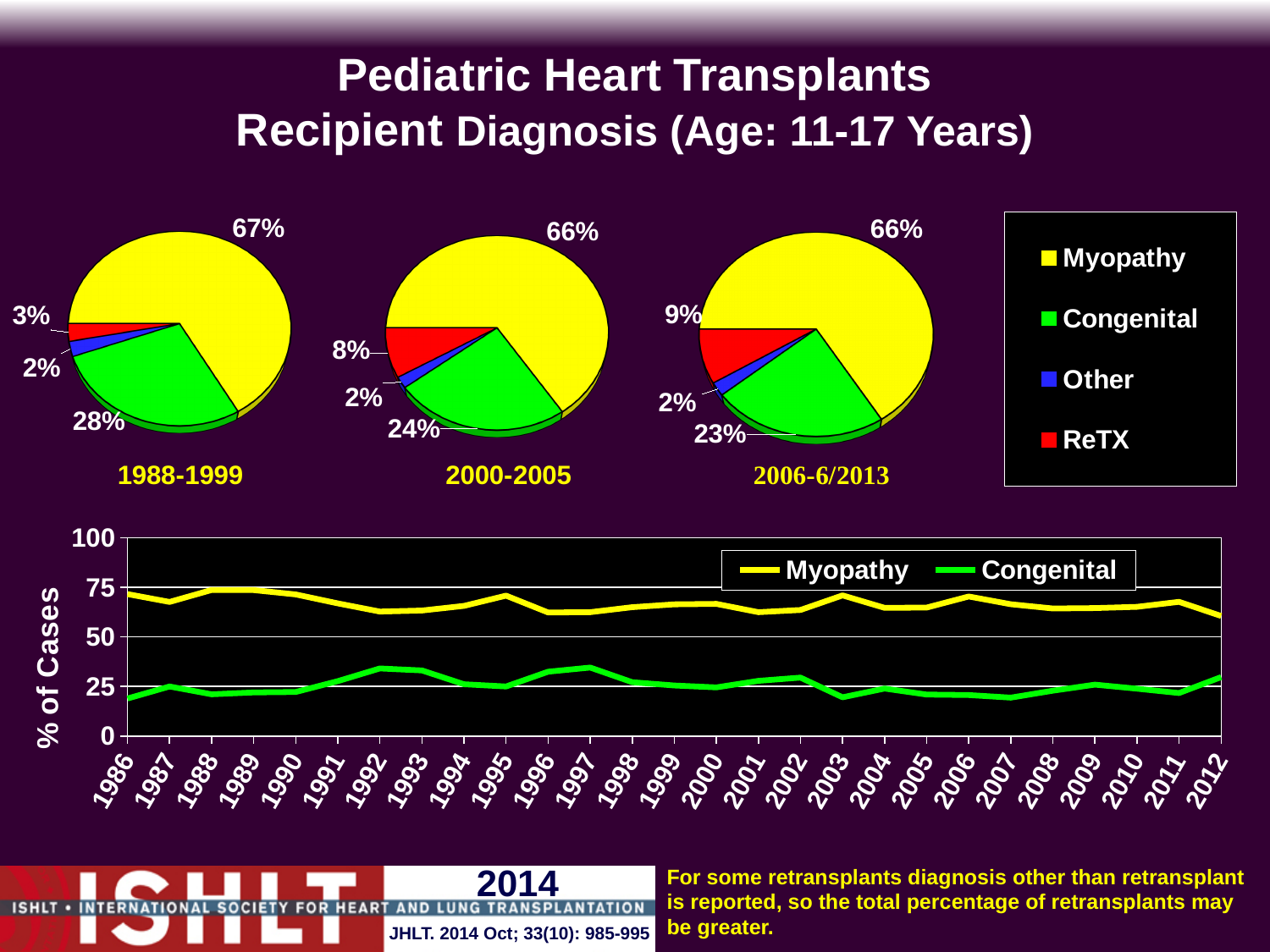
In the 2006-6/2013 pie chart, which diagnosis has the largest share? Myopathy How many pie charts are shown on the slide? 3 In the 1988-1999 pie chart, what percentage of cases is Myopathy? 67% In the 2000-2005 pie chart, which diagnosis has the smallest share? Other How many series does the legend of the line chart at the bottom list? 2 In the 2006-6/2013 pie chart, what percentage of cases is Congenital? 23% In the 2000-2005 pie chart, what percentage of cases is ReTX? 8% What kind of chart is the chart at the bottom of the slide? Line chart Is the ReTX share larger in the 1988-1999 pie chart or the 2006-6/2013 pie chart? 2006-6/2013 In the line chart at the bottom, is the Myopathy value for 2012 greater or less than 50? greater In the 1988-1999 pie chart, what is the difference between the Myopathy and Congenital shares? 39% In the line chart at the bottom, is the Congenital value for 2003 greater or less than 25? less